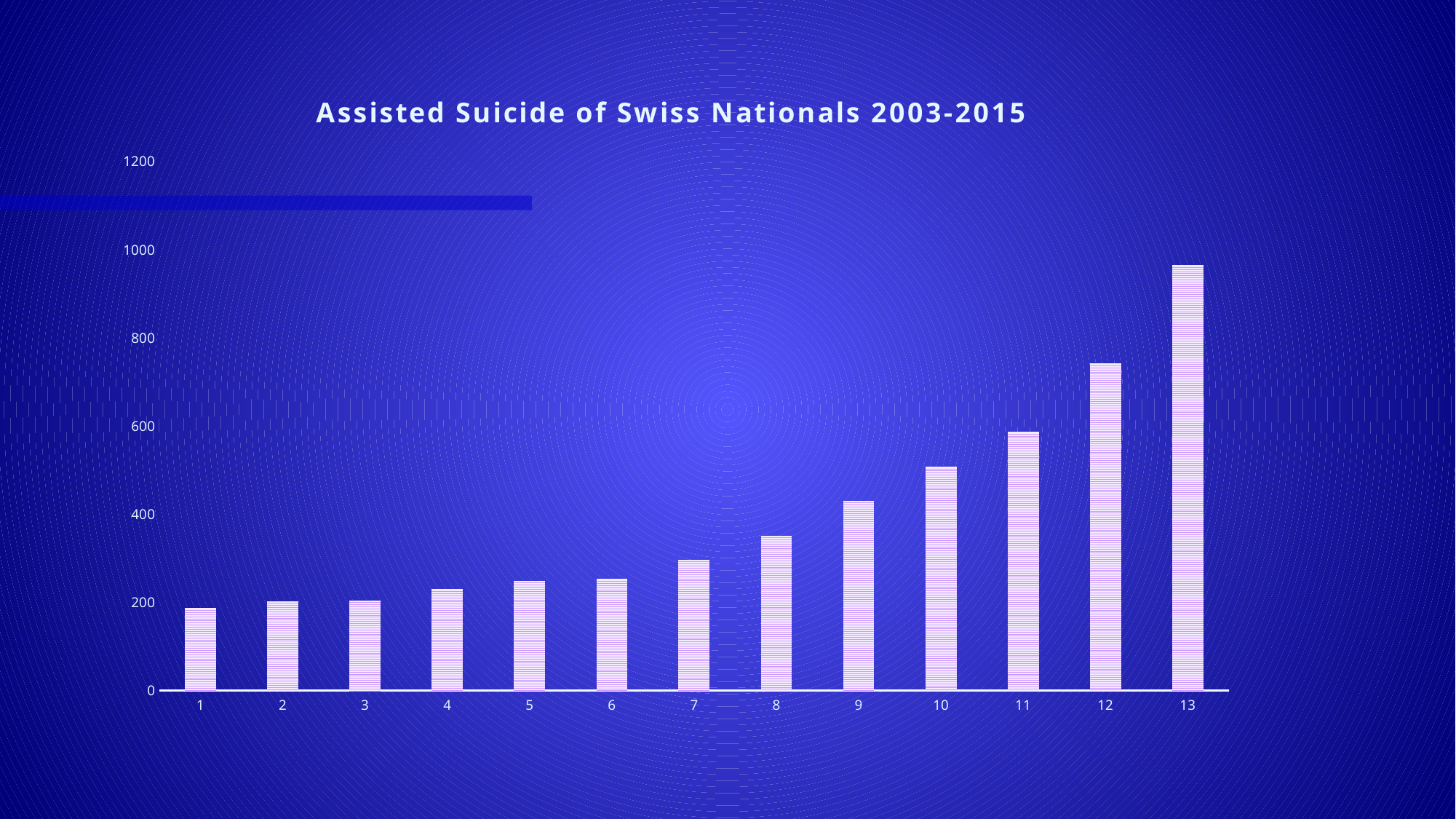
Which is larger, the value for category 5 or the value for category 9? 9 Is the value for category 13 greater or less than 800? greater Do the values generally rise or fall from category 1 to category 13? rise What type of chart is shown on the slide? bar chart Is the value for category 9 greater or less than 400? greater How many bars (categories) are plotted in the chart? 13 Is the value for category 10 greater or less than 600? less Which is larger, the value for category 12 or the value for category 13? 13 What is the title of the chart? Assisted Suicide of Swiss Nationals 2003-2015 Which category has the highest bar? 13